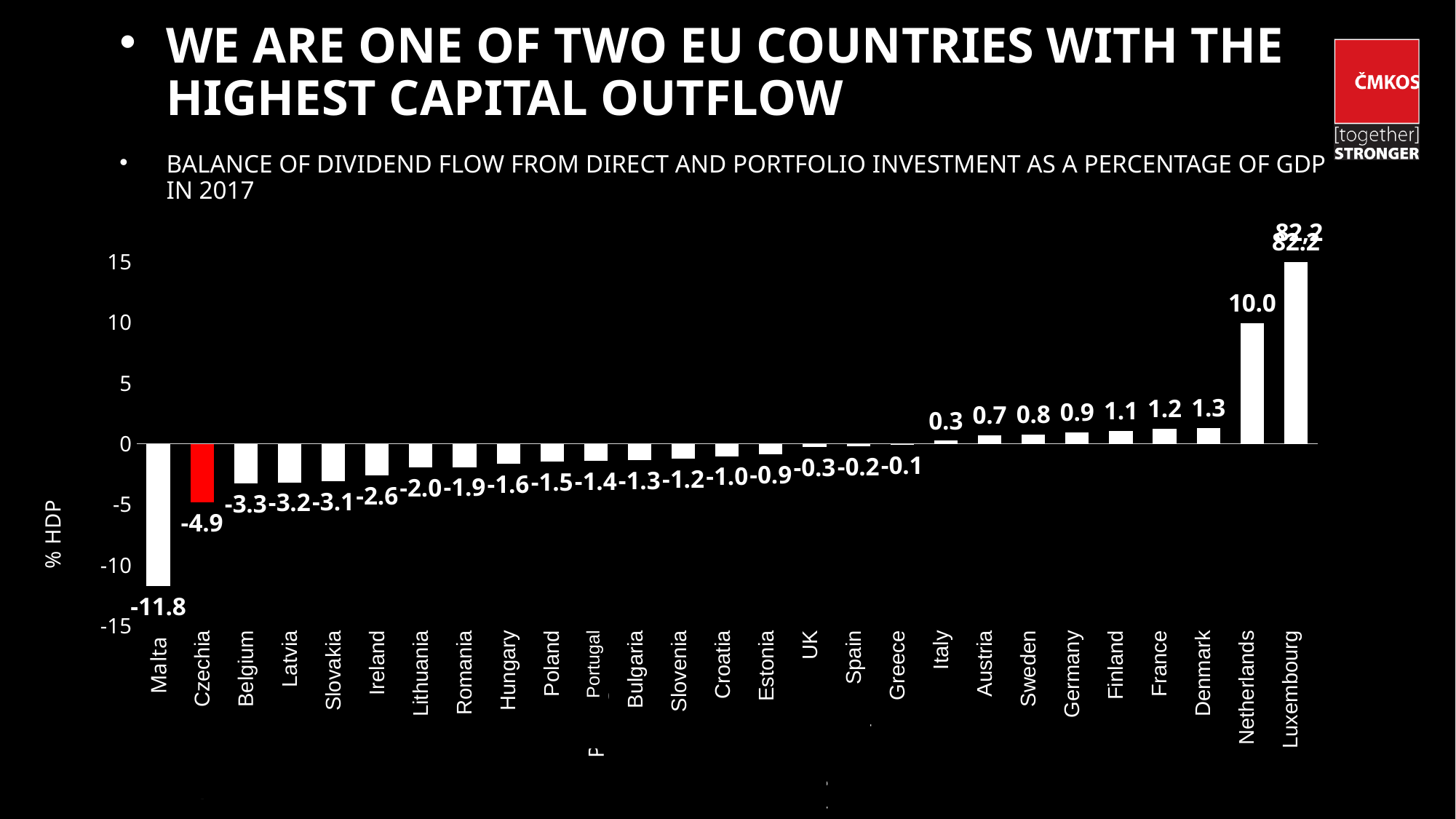
What is the value for Netherlands? 10.0 Which has a larger value, Ireland or Slovakia? Ireland Which country has the lowest value? Malta What is the value for Denmark? 1.3 Which country's bar is highlighted in red? Czechia What kind of chart is shown on the slide? Bar chart What is the value for Malta? -11.8 What is the value for Luxembourg? 82.2 Which country has the highest value? Luxembourg How many countries are shown in the chart? 27 What is the value for Czechia? -4.9 What is the difference between the values for Netherlands and Denmark? 8.7